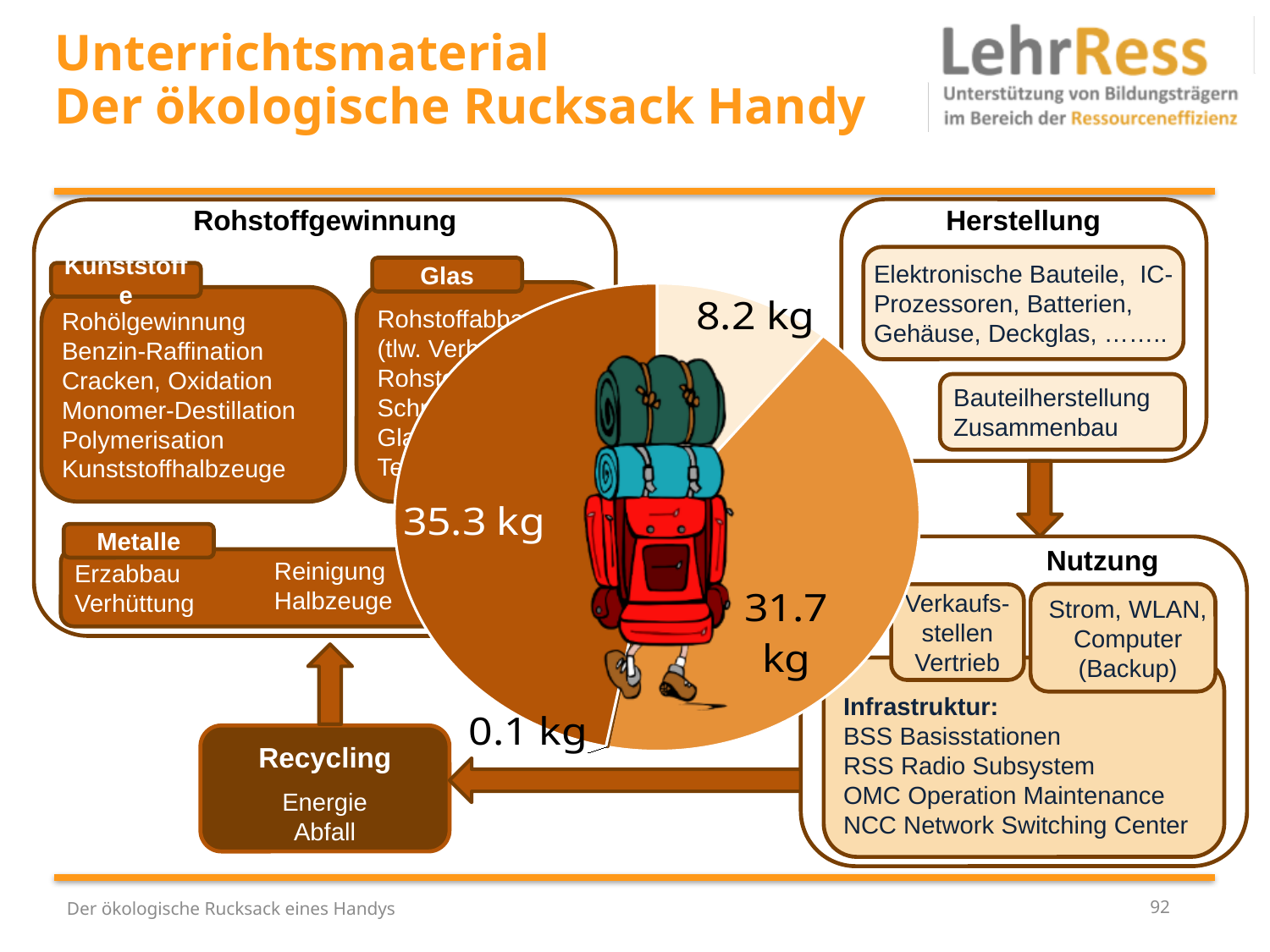
What is the difference between the 31.7 kg slice and the 8.2 kg slice? 23.5 kg What unit are the values in the pie chart given in? kg What value is printed on the orange slice on the right side of the pie chart? 31.7 kg What is the total of all slice values in the pie chart? 75.3 kg What is the value of the largest slice of the pie chart? 35.3 kg What value is printed on the light-coloured slice at the top right of the pie chart? 8.2 kg Which is larger, the 35.3 kg slice or the 31.7 kg slice? 35.3 kg What kind of chart is shown on the slide? pie chart What value is printed on the dark brown slice on the left side of the pie chart? 35.3 kg How many slices does the pie chart have? 4 What is the difference between the 35.3 kg slice and the 31.7 kg slice? 3.6 kg What is the value of the smallest slice of the pie chart? 0.1 kg